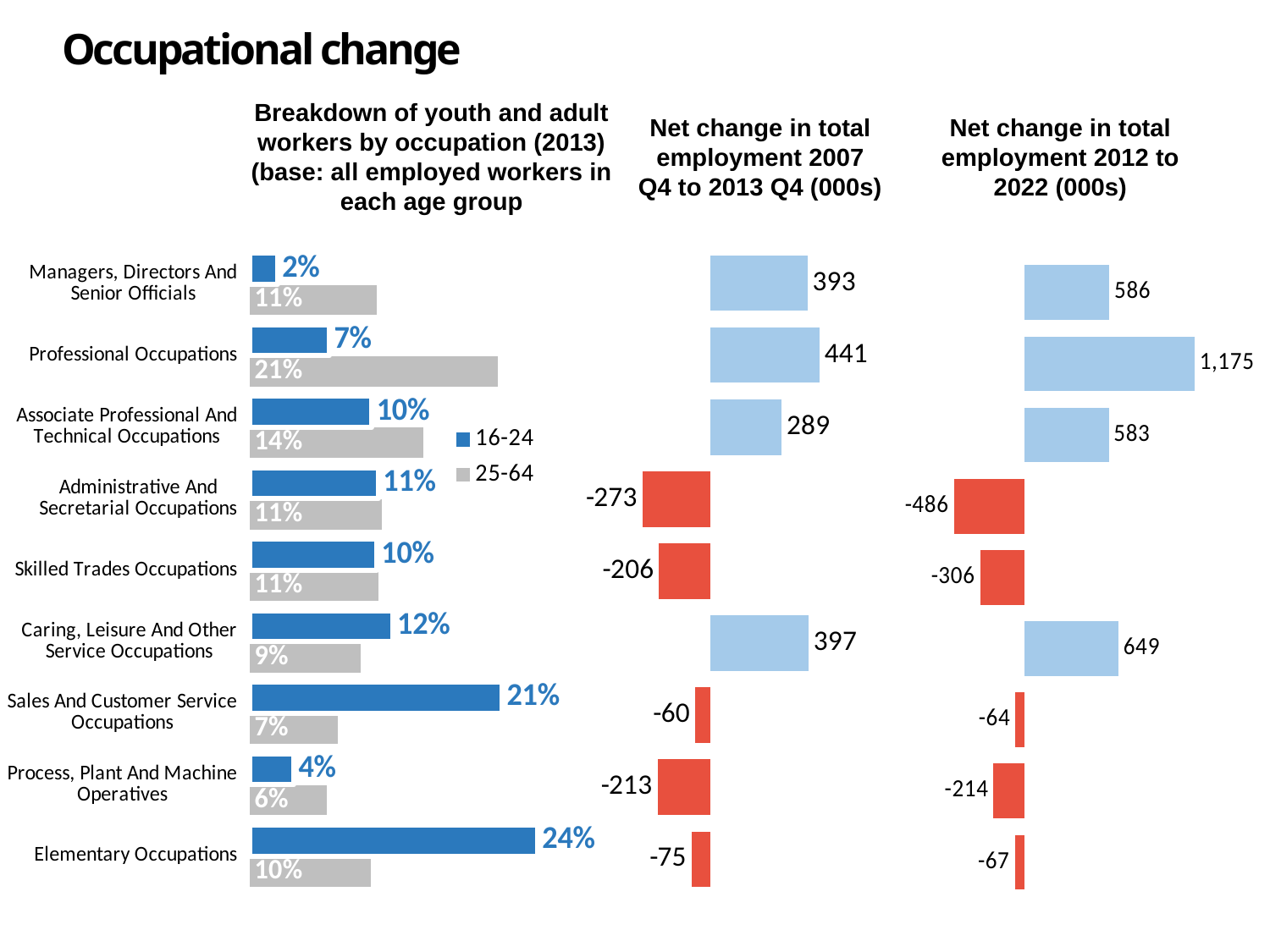
In the 'Net change in total employment 2007 Q4 to 2013 Q4 (000s)' chart, which is larger: Managers, Directors And Senior Officials or Associate Professional And Technical Occupations? Managers, Directors And Senior Officials In the 'Net change in total employment 2007 Q4 to 2013 Q4 (000s)' chart, which occupation has the lowest value? Administrative And Secretarial Occupations In the 'Net change in total employment 2007 Q4 to 2013 Q4 (000s)' chart, what is the value for Professional Occupations? 441 In the 'Breakdown of youth and adult workers by occupation (2013)' chart, how many occupation categories are shown? 9 In the 'Breakdown of youth and adult workers by occupation (2013)' chart, what is the value for 25-64 in Professional Occupations? 21% In the 'Breakdown of youth and adult workers by occupation (2013)' chart, what is the value for 16-24 in Sales And Customer Service Occupations? 21% In the 'Net change in total employment 2012 to 2022 (000s)' chart, what is the difference between Caring, Leisure And Other Service Occupations and Managers, Directors And Senior Officials? 63 What kind of chart is the 'Net change in total employment 2012 to 2022 (000s)' chart? Bar chart In the 'Breakdown of youth and adult workers by occupation (2013)' chart, which occupation has the highest 16-24 value? Elementary Occupations In the 'Breakdown of youth and adult workers by occupation (2013)' chart, what is the difference between the 16-24 and 25-64 values for Elementary Occupations? 14 percentage points In the 'Breakdown of youth and adult workers by occupation (2013)' chart, how many series does the legend list? 2 In the 'Net change in total employment 2012 to 2022 (000s)' chart, which occupation has the highest value? Professional Occupations